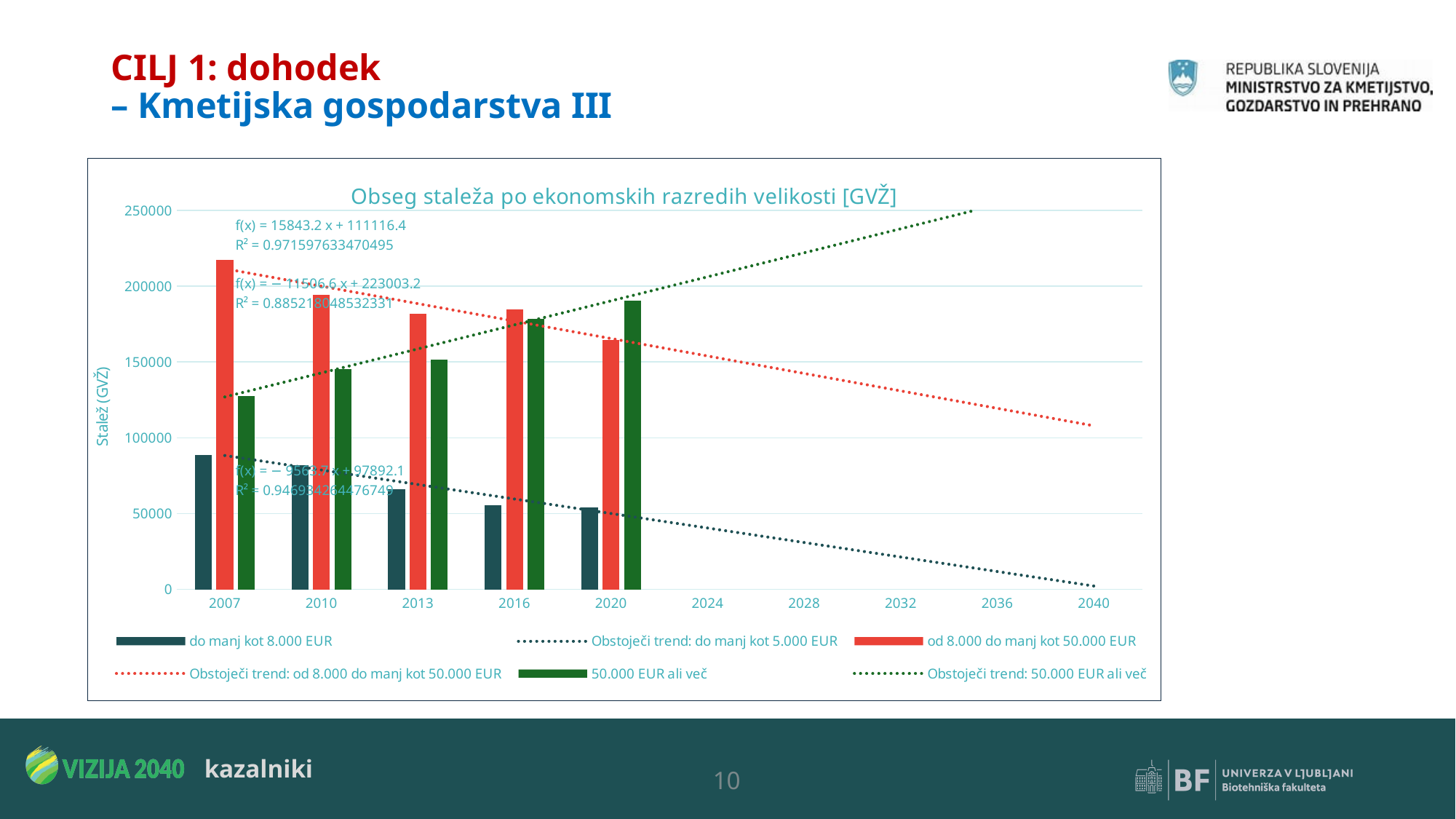
Do the bars for '50.000 EUR ali več' rise or fall from 2007 to 2020? rise Is the value for 'od 8.000 do manj kot 50.000 EUR' in 2007 greater or less than 200000? greater For how many years are bars plotted in the chart? 5 What kind of chart is shown on the slide? bar chart What is the title of the chart? Obseg staleža po ekonomskih razredih velikosti [GVŽ] In 2020, which is larger: the bar for '50.000 EUR ali več' or the bar for 'od 8.000 do manj kot 50.000 EUR'? 50.000 EUR ali več Which series has the lowest bar in 2020? do manj kot 8.000 EUR Is the value for 'od 8.000 do manj kot 50.000 EUR' in 2013 greater or less than 200000? less How many entries does the chart legend list? 6 Is the value for '50.000 EUR ali več' in 2020 greater or less than 150000? greater Which series has the highest bar in 2007? od 8.000 do manj kot 50.000 EUR